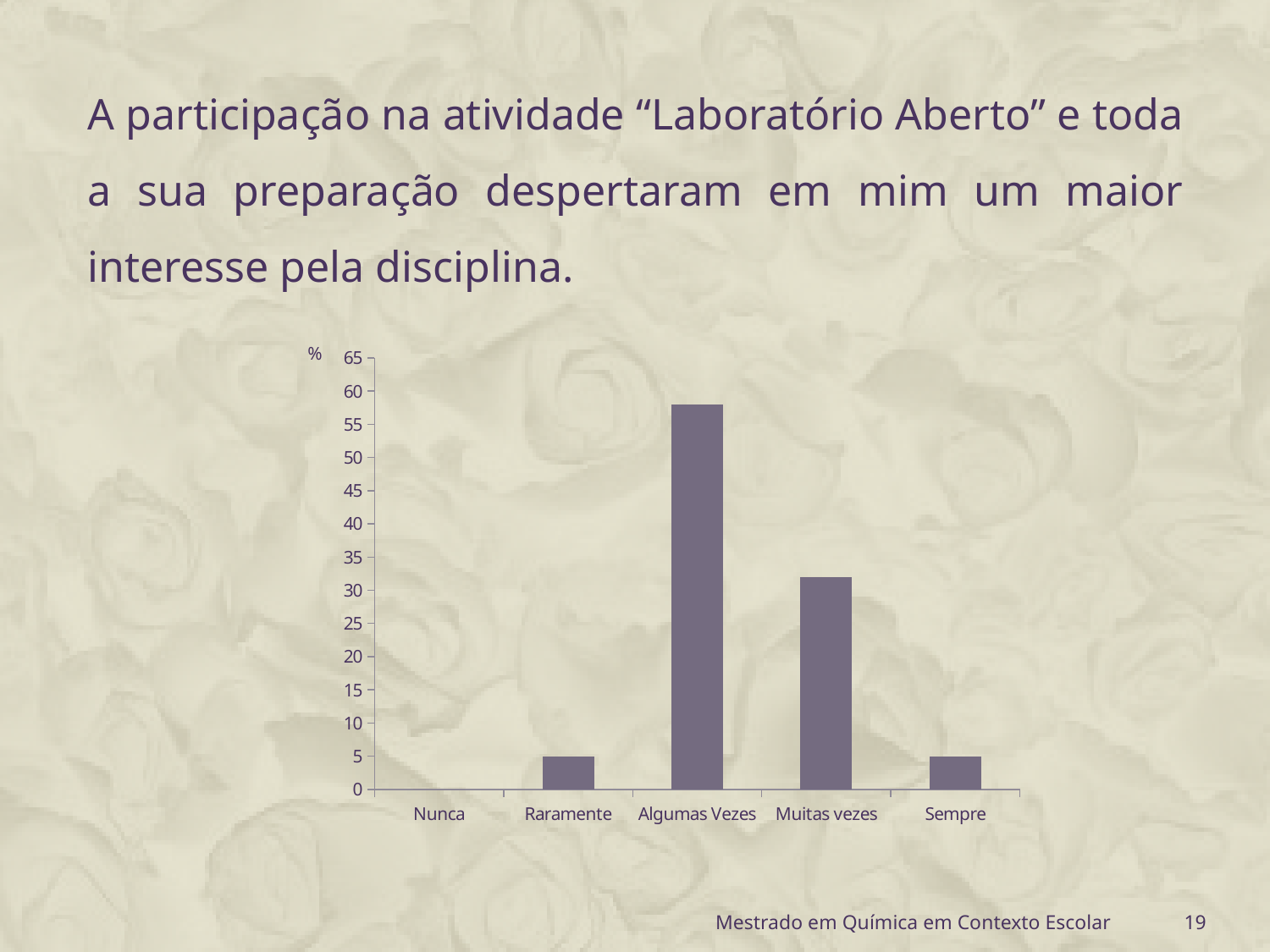
Which is larger, the value for Algumas Vezes or the value for Muitas vezes? Algumas Vezes How many categories are shown on the x axis of the chart? 5 What kind of chart is shown on the slide? bar chart Is the value for Muitas vezes greater or less than 35? less Is the value for Algumas Vezes greater or less than 60? less What unit is shown at the top of the vertical axis of the chart? % Which category has the lowest value in the chart? Nunca Which category has the highest value in the chart? Algumas Vezes What is the value for Raramente? 5 Is the value for Algumas Vezes greater or less than 55? greater What is the value for Sempre? 5